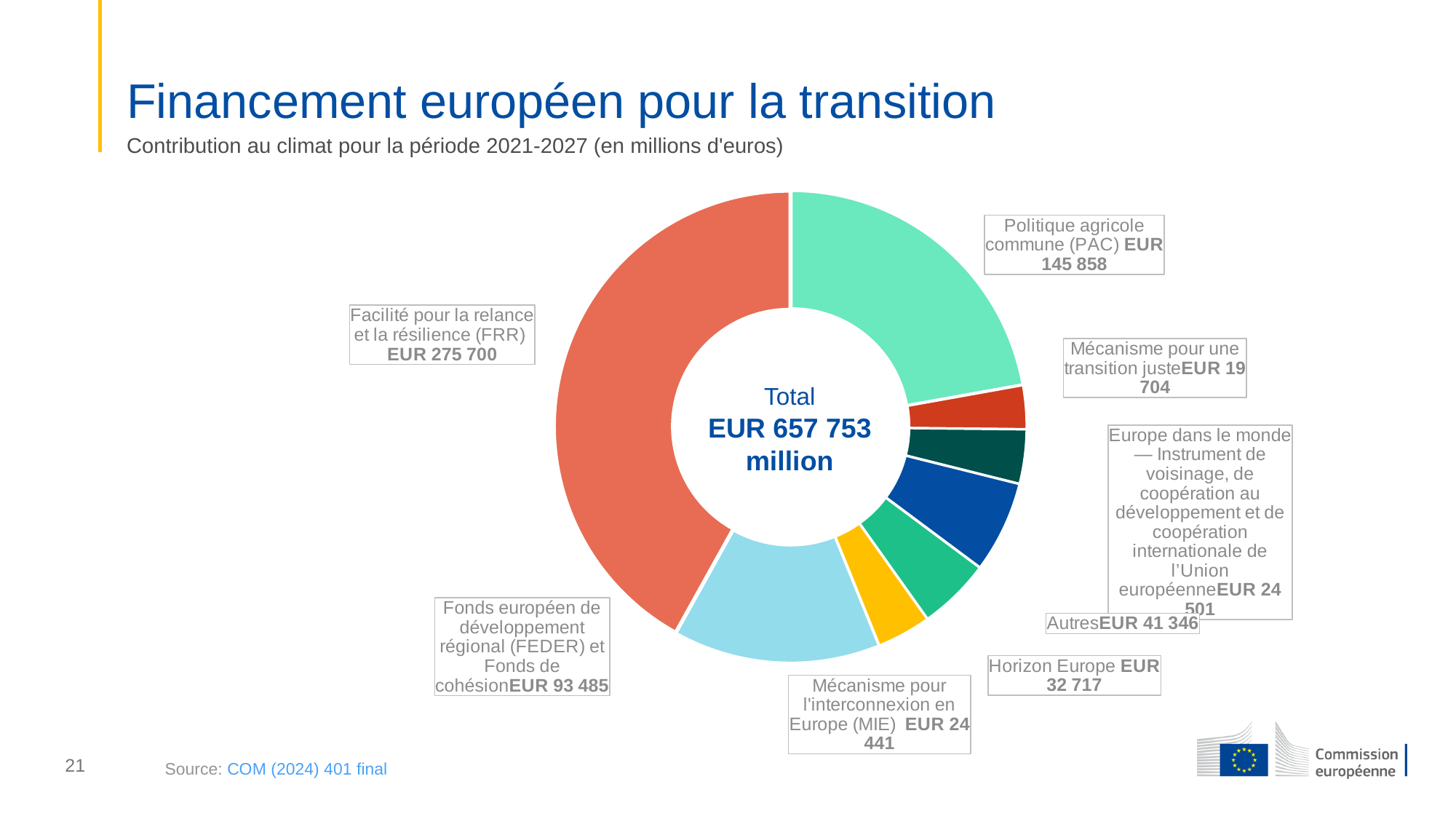
What total is shown in the centre of the chart? EUR 657 753 million Which category has the smallest slice of the chart? Mécanisme pour une transition juste What is the difference between the Autres value and the Horizon Europe value? EUR 8 629 Which is larger, the value for Autres or the value for Horizon Europe? Autres What is the difference between the FRR value and the PAC value? EUR 129 842 What is the value for Politique agricole commune (PAC)? EUR 145 858 What is the value for Horizon Europe? EUR 32 717 What is the value for Mécanisme pour une transition juste? EUR 19 704 Which category has the largest slice of the chart? Facilité pour la relance et la résilience (FRR) What kind of chart is shown on the slide? Pie chart (donut) How many categories are shown in the chart? 8 What is the value for Facilité pour la relance et la résilience (FRR)? EUR 275 700